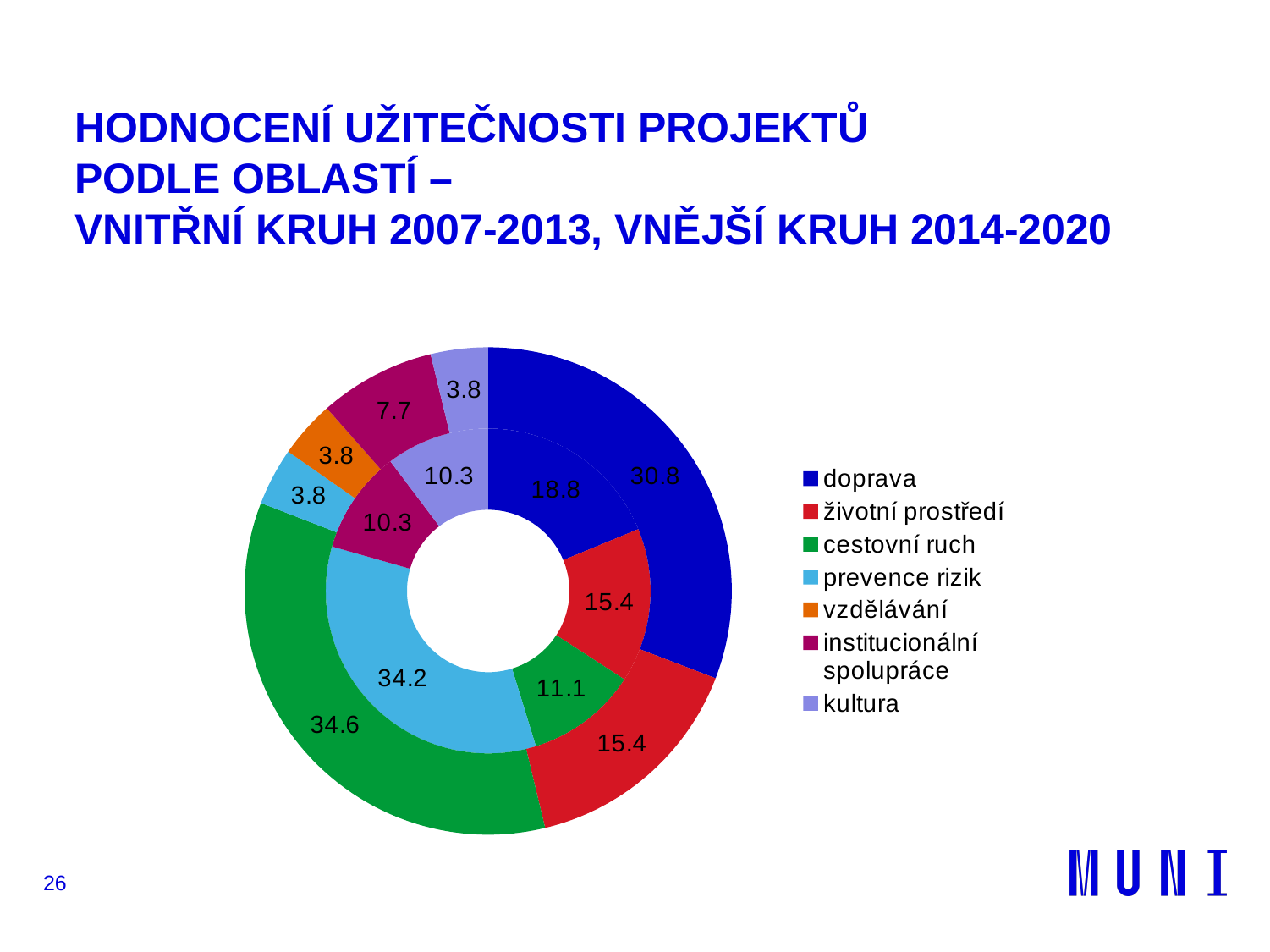
How many entries does the legend list? 7 Which category has the largest value in the outer ring (2014-2020)? cestovní ruch What is the difference between the doprava values in the outer ring (30.8) and the inner ring (18.8)? 12 What is the value for doprava in the outer ring (2014-2020)? 30.8 What is the value for prevence rizik in the inner ring (2007-2013)? 34.2 Which category has the largest value in the inner ring (2007-2013)? prevence rizik What kind of chart is shown on the slide? doughnut chart Which legend entry is shown in orange? vzdělávání How many segments does the outer ring (2014-2020) have? 7 Which is larger: prevence rizik in the inner ring or prevence rizik in the outer ring? inner ring (34.2) What is the value for cestovní ruch in the outer ring (2014-2020)? 34.6